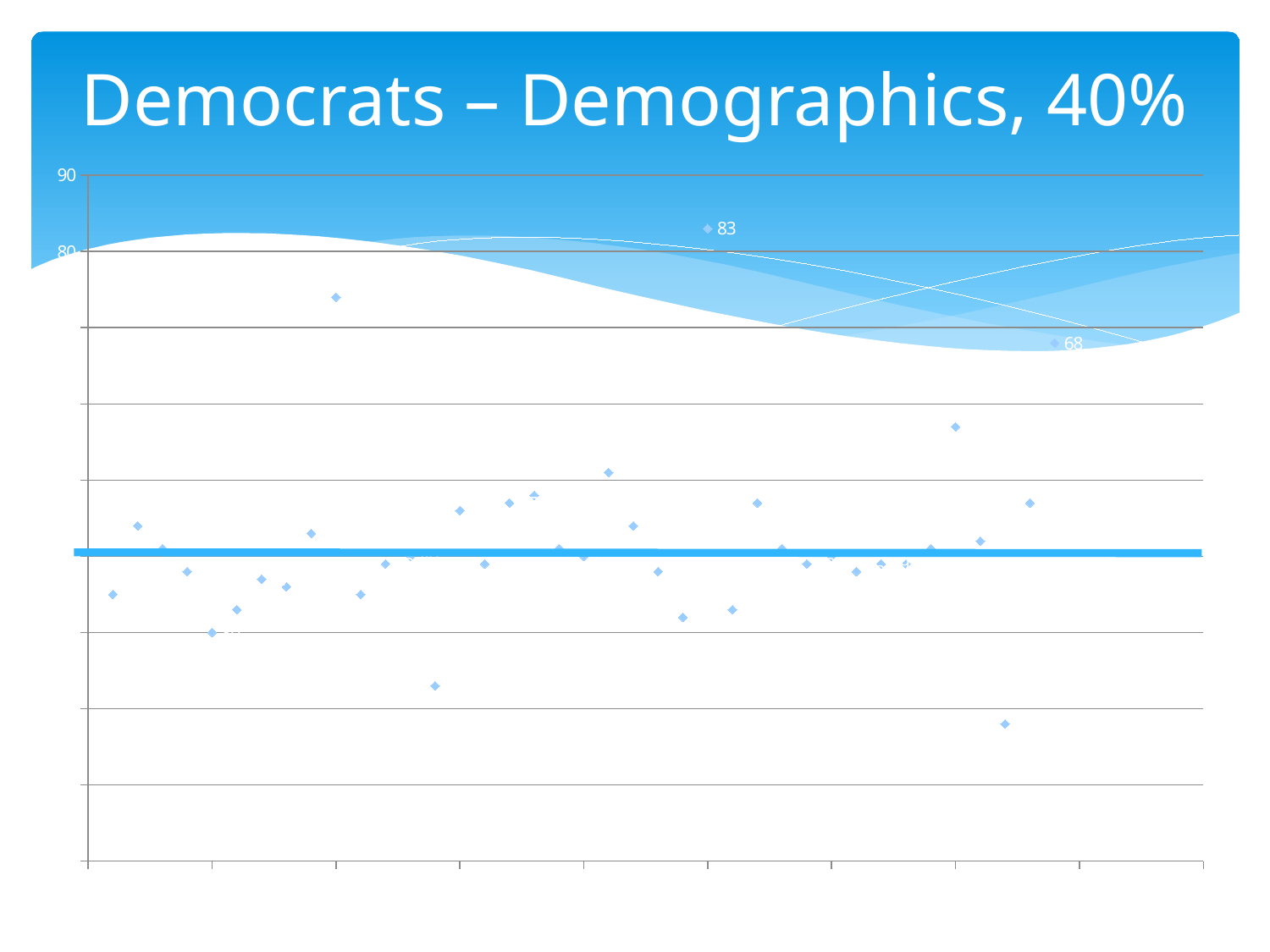
What is the highest data label printed on the chart? 83 What is the topmost value shown on the vertical axis? 90 What kind of chart is shown on the slide? scatter chart Is the value of the highest point on the chart greater or less than 80? greater Is the value of the point labelled 68 greater or less than 80? less What is the value of the labelled point near the right side of the chart, just below the 70 gridline? 68 What is the difference between the two labelled points, 83 and 68? 15 What is the title of the chart on the slide? Democrats – Demographics, 40% Which labelled point is larger, the one labelled 83 or the one labelled 68? 83